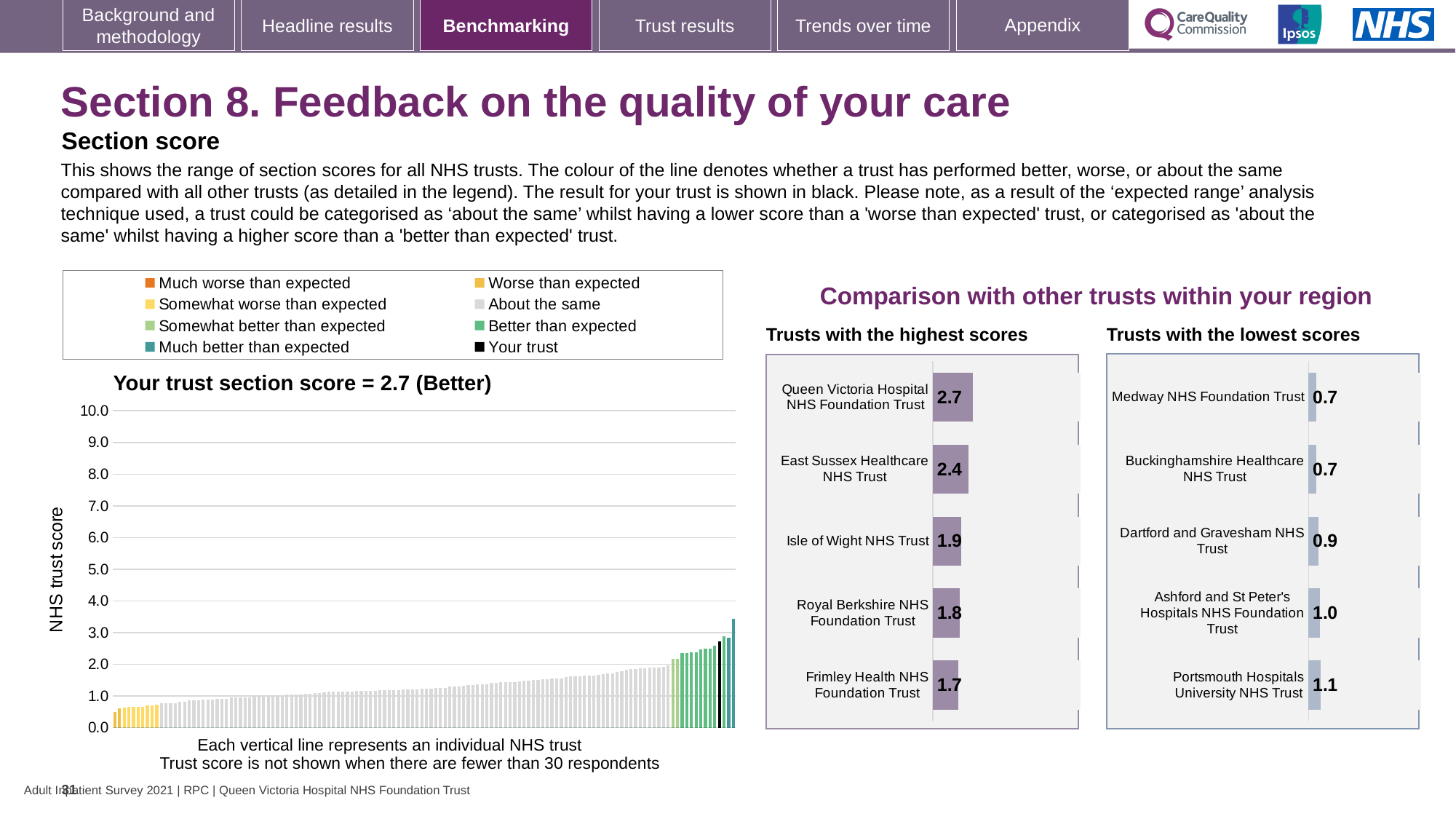
In the 'Trusts with the highest scores' chart, what is the score for East Sussex Healthcare NHS Trust? 2.4 In the 'Trusts with the highest scores' chart, which trust has the highest score? Queen Victoria Hospital NHS Foundation Trust In the 'Trusts with the lowest scores' chart, which trust has the highest score? Portsmouth Hospitals University NHS Trust How many entries does the legend above the 'Your trust section score' chart list? 8 In the 'Trusts with the highest scores' chart, how many trusts are shown? 5 In the 'Your trust section score' chart, what is the section score for your trust? 2.7 In the 'Trusts with the highest scores' chart, what is the difference between the scores of Queen Victoria Hospital NHS Foundation Trust and Frimley Health NHS Foundation Trust? 1.0 In the 'Trusts with the lowest scores' chart, what is the difference between the scores of Portsmouth Hospitals University NHS Trust and Medway NHS Foundation Trust? 0.4 In the 'Trusts with the highest scores' chart, which trust has the lowest score? Frimley Health NHS Foundation Trust In the 'Your trust section score' chart, do the bars rise or fall from left to right? rise In the 'Trusts with the lowest scores' chart, what is the score for Dartford and Gravesham NHS Trust? 0.9 In the 'Trusts with the lowest scores' chart, which has the larger score: Dartford and Gravesham NHS Trust or Ashford and St Peter's Hospitals NHS Foundation Trust? Ashford and St Peter's Hospitals NHS Foundation Trust